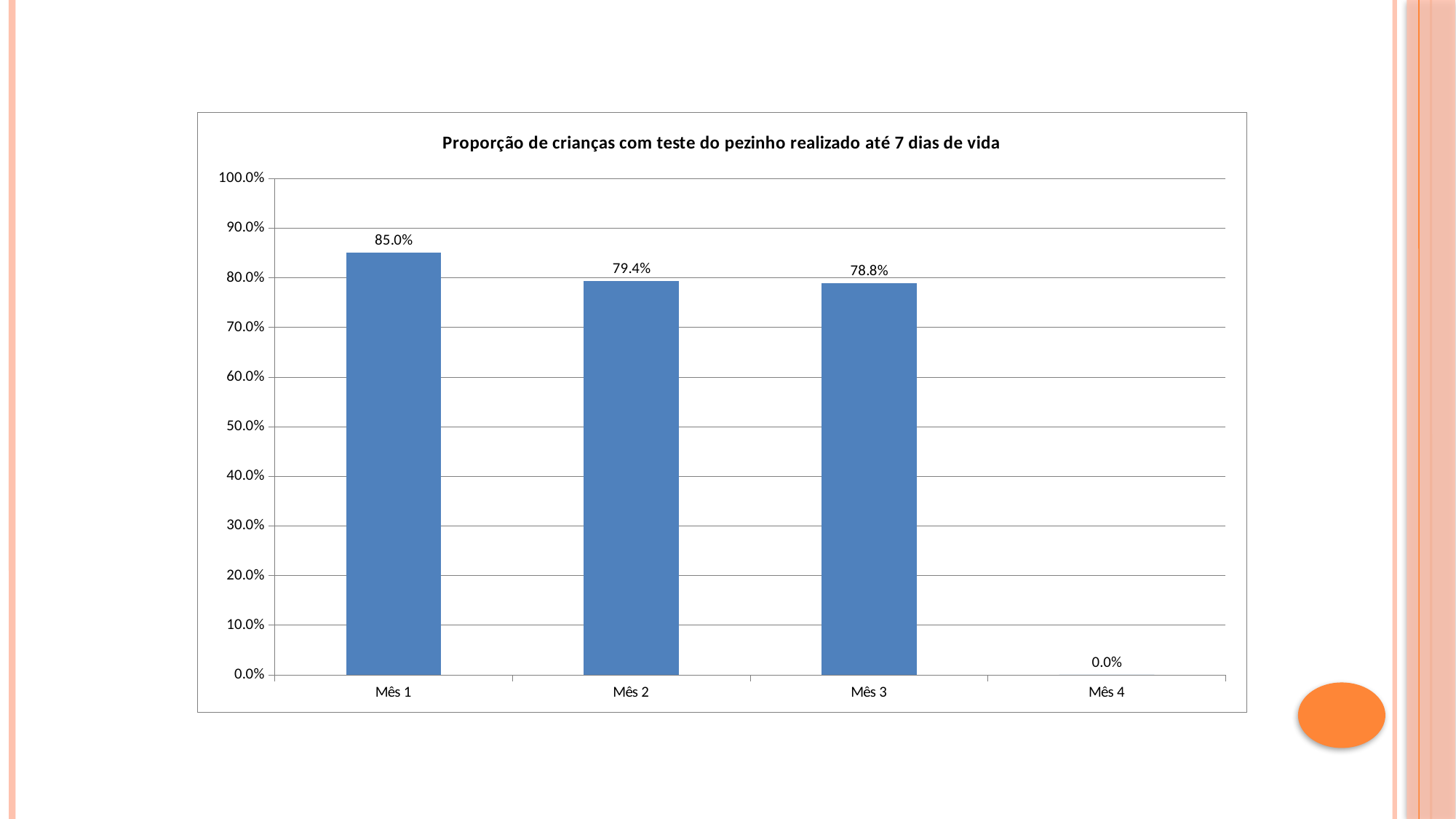
What is the value for Mês 3? 78.8% Which month has the lowest value? Mês 4 Which is larger, the value for Mês 1 or the value for Mês 3? Mês 1 What is the title of the chart? Proporção de crianças com teste do pezinho realizado até 7 dias de vida How many months are shown on the x axis? 4 What is the difference between the values for Mês 1 and Mês 2? 5.6% What kind of chart is this? Bar chart What is the value for Mês 2? 79.4% Which month has the highest value? Mês 1 What is the difference between the values for Mês 2 and Mês 3? 0.6% What is the value for Mês 4? 0.0% What is the value for Mês 1? 85.0%